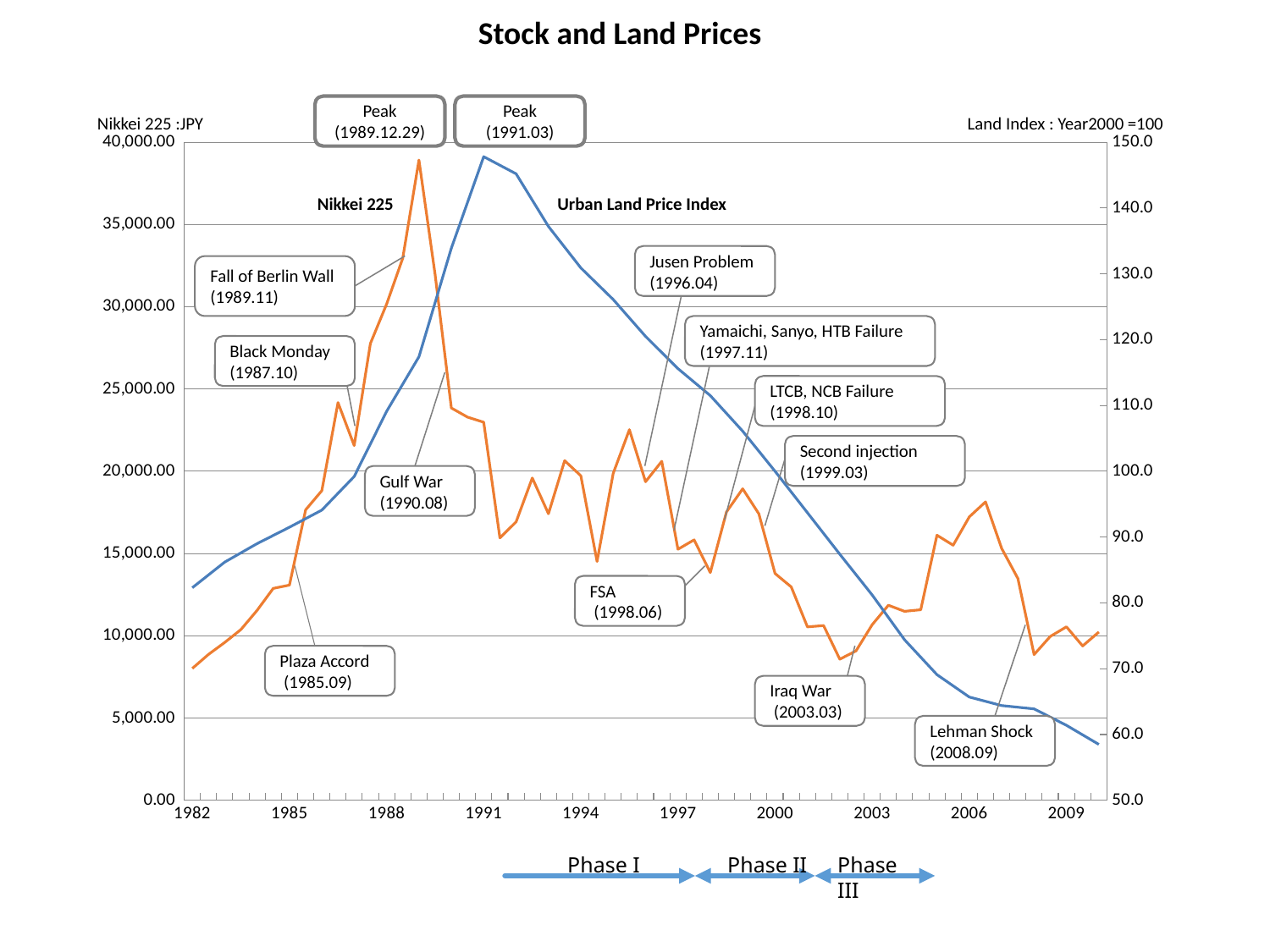
Does the Urban Land Price Index rise or fall from 1991 to 2009? fall Is the Nikkei 225 value in 1982 greater or less than 10,000.00? less Is the Nikkei 225 value in 2006 greater or less than 15,000.00? greater Does the Nikkei 225 rise or fall from 1982 to 1989? rise Is the Urban Land Price Index value in 2009 greater or less than 70.0? less Which is larger, the Nikkei 225 value in 1989 or in 2003? 1989 What kind of chart is shown on the slide? line chart What is the title of the chart? Stock and Land Prices How many data series are plotted on the chart? 2 Which series is plotted in orange? Nikkei 225